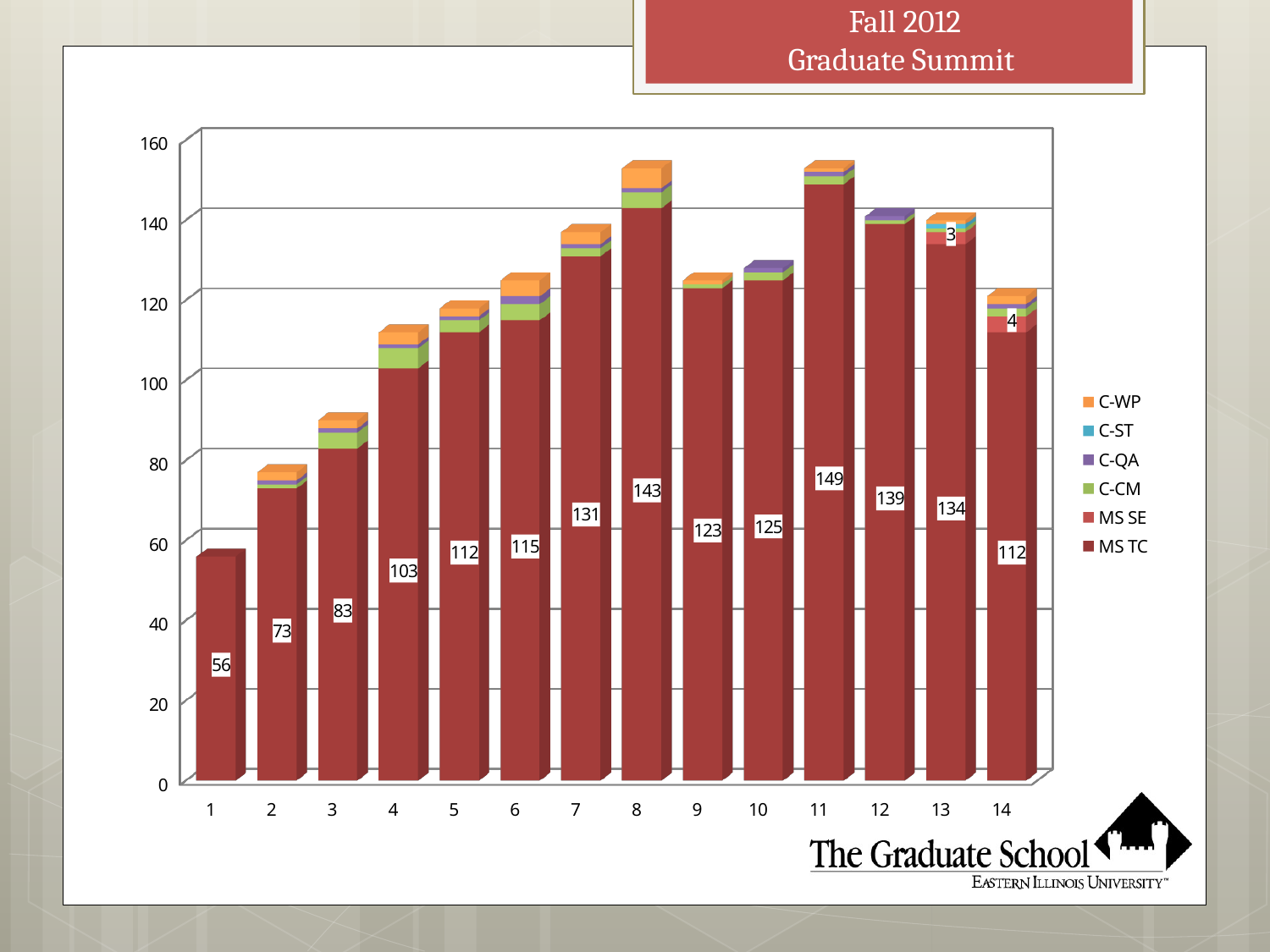
How many series does the legend list? 6 What is the difference between the MS TC values for categories 8 and 7? 12 What is the MS TC value for category 11? 149 Which category has the lowest MS TC value? 1 Is the total height of the stacked bar for category 8 greater or less than 140? greater What is the MS SE value for category 13? 3 Which category has the highest MS TC value? 11 How many categories are shown on the x axis? 14 What is the MS SE value for category 14? 4 What is the MS TC value for category 1? 56 What kind of chart is shown on the slide? stacked bar chart Which is larger, the MS TC value for category 12 or for category 13? category 12